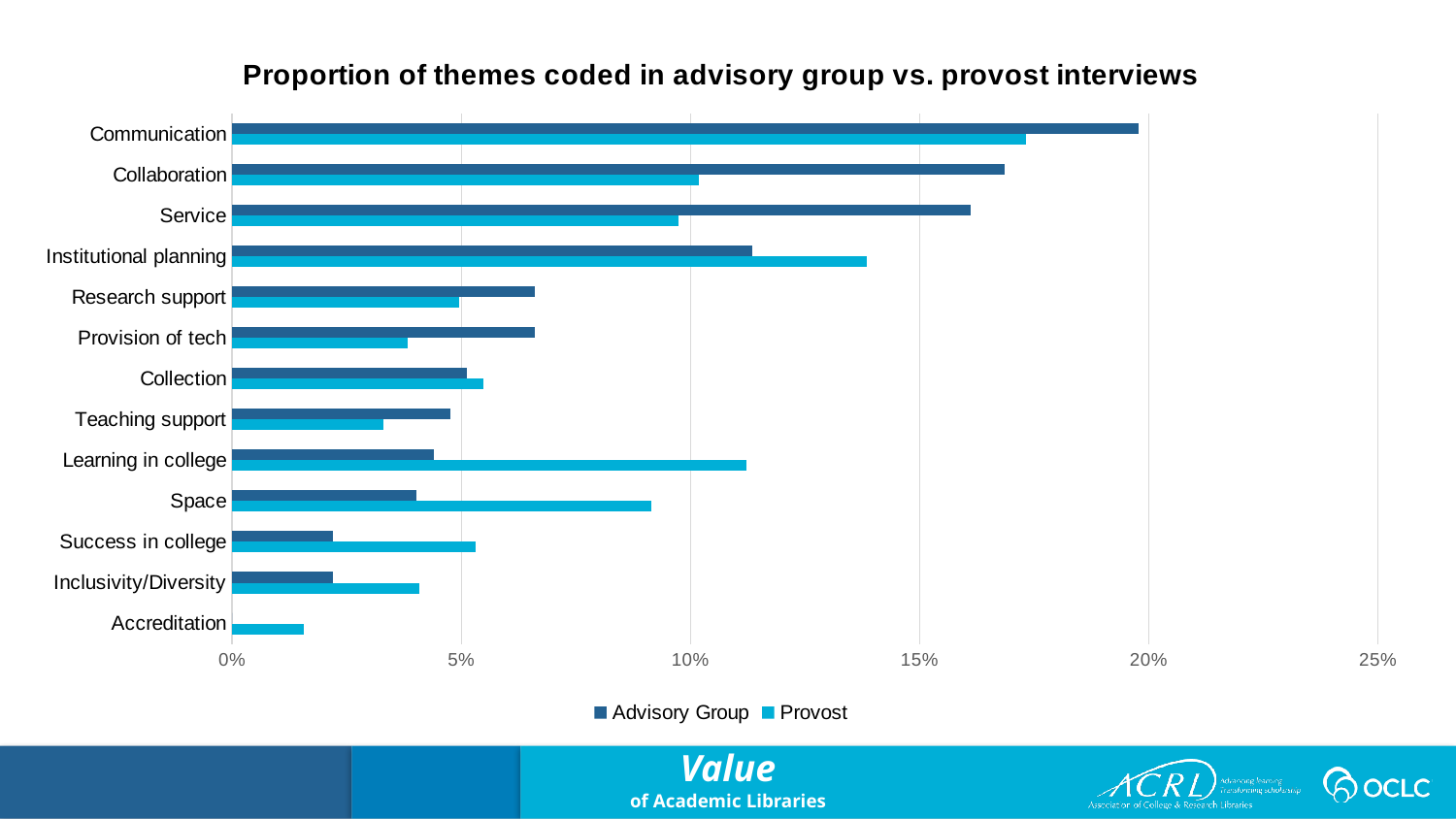
How many series does the legend list? 2 How many theme categories are plotted on the chart? 13 Is the Advisory Group value for Communication greater or less than 15%? greater What is the title of the chart? Proportion of themes coded in advisory group vs. provost interviews Which theme has the lowest Provost value? Accreditation Which theme has the highest Advisory Group value? Communication For Institutional planning, which series has the larger value, Advisory Group or Provost? Provost Is the Provost value for Space greater or less than 10%? less For Learning in college, which series has the larger value, Advisory Group or Provost? Provost Which theme has the highest Provost value? Communication For Service, which series has the larger value, Advisory Group or Provost? Advisory Group What kind of chart is shown on the slide? Bar chart